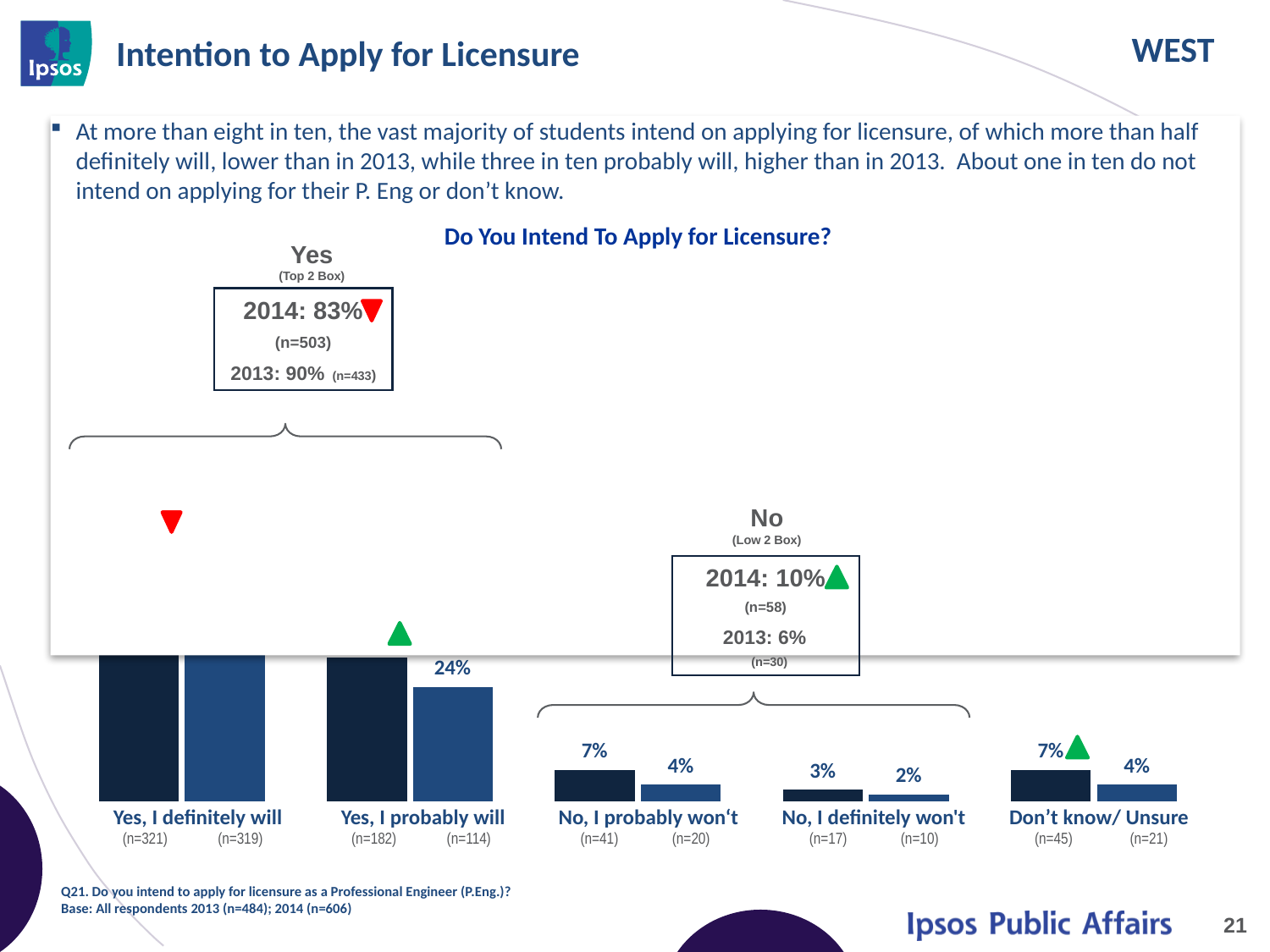
What value is printed on the lighter blue bar for "No, I probably won't"? 4% Which is larger: the dark navy bar for "No, I definitely won't" or the dark navy bar for "Don't know/ Unsure"? Don't know/ Unsure What value is printed on the dark navy bar for "No, I definitely won't"? 3% What kind of chart is shown on the slide? bar chart What value is printed on the lighter blue bar for "Don't know/ Unsure"? 4% What value is printed on the dark navy bar for "No, I probably won't"? 7% What is the 2014 "Yes (Top 2 Box)" percentage shown in the annotation box? 83% What is the title of the chart? Do You Intend To Apply for Licensure? What is the difference between the dark navy bar and the lighter blue bar for "No, I probably won't"? 3% What value is printed on the lighter blue bar for "Yes, I probably will"? 24% Which category has the tallest bars in the chart? Yes, I definitely will How many response categories are shown along the x axis of the chart? 5